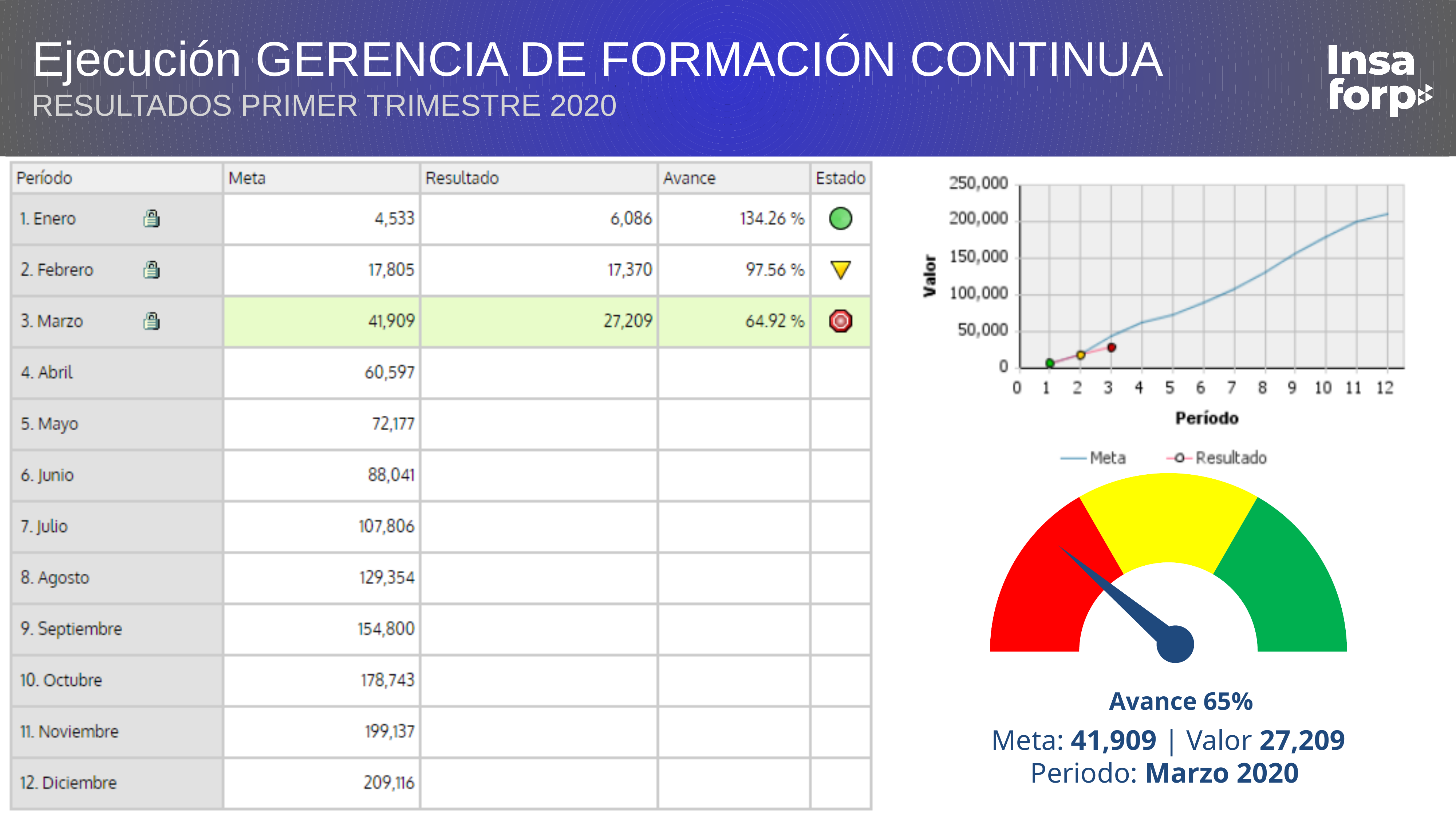
In the line chart on the right, how many series does the legend list? 2 In the gauge chart at the bottom right, what is the Valor shown for Marzo 2020? 27,209 In the line chart on the right, is the Meta value at Período 6 greater or less than 100,000? less In the gauge chart at the bottom right, what Avance percentage is shown? 65% In the line chart on the right, does the Meta line rise or fall as Período increases from 1 to 12? rises In the line chart on the right, is the Meta value at Período 12 greater or less than 200,000? greater In the gauge chart at the bottom right, which coloured zone does the needle point into? red In the line chart on the right, at Período 3, which is larger: Meta or Resultado? Meta In the line chart on the right, what are the two series named in the legend? Meta and Resultado In the gauge chart at the bottom right, what is the difference between the Meta (41,909) and the Valor (27,209)? 14,700 In the line chart on the right, how many data points does the Resultado series show? 3 What kind of chart is the upper chart on the right, plotting Valor against Período? line chart